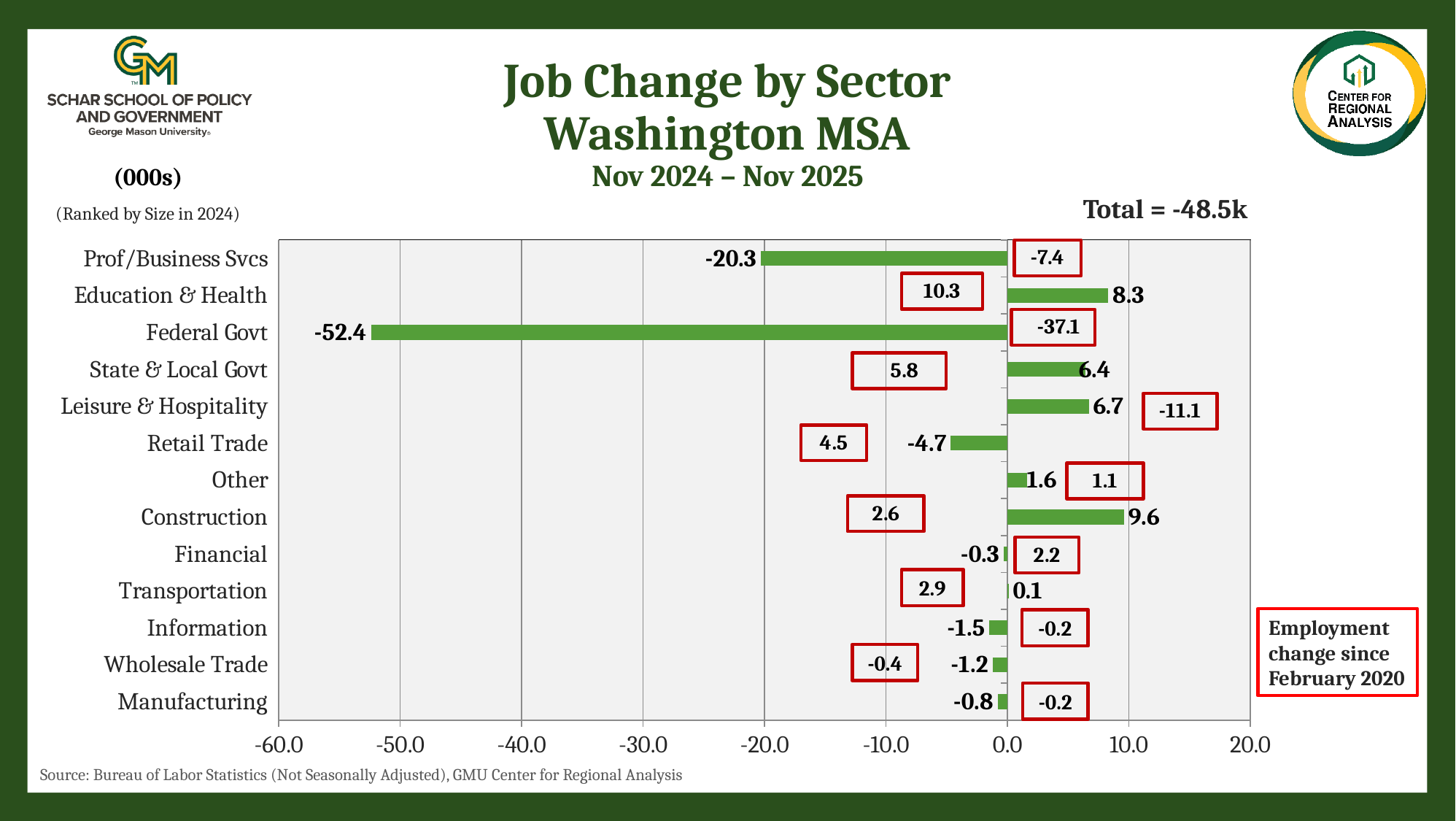
What is the difference between the job change for Construction and Education & Health? 1.3 Which sector has the largest job loss (lowest bar value)? Federal Govt What is the job change value for Federal Govt? -52.4 Which sector has the largest job gain (highest bar value)? Construction What type of chart is shown on the slide? Bar chart What is the job change value for Prof/Business Svcs? -20.3 What total job change is stated above the chart? -48.5k What is the job change value for Retail Trade? -4.7 What period does the chart title say the job change covers? Nov 2024 – Nov 2025 What is the job change value for Construction? 9.6 How many sectors are shown in the chart? 13 Which sector has a larger job change, Leisure & Hospitality or State & Local Govt? Leisure & Hospitality